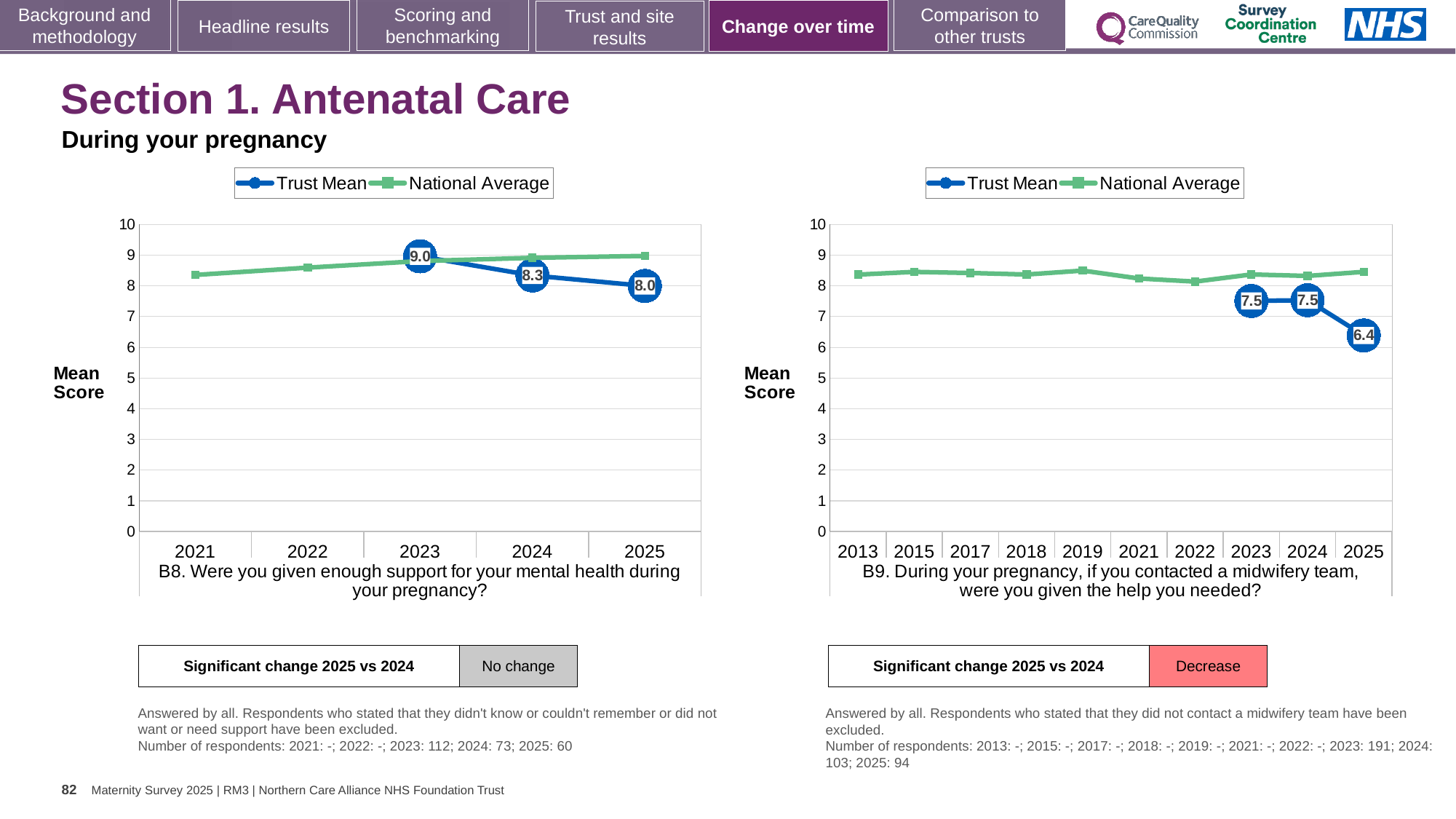
In the B9 chart (right), which year has the lowest Trust Mean? 2025 In the B8 chart (left), what is the difference between the Trust Mean for 2023 and 2025? 1.0 In the B9 chart (right), what is the Trust Mean for 2025? 6.4 In the B9 chart (right), is the National Average for 2025 greater or less than 8? greater How many years are shown on the x axis of the B9 chart (right)? 10 In the B8 chart (left), does the Trust Mean rise or fall from 2023 to 2025? fall In the B8 chart (left), what is the Trust Mean for 2023? 9.0 How many series does the legend of the B8 chart (left) list? 2 In the B9 chart (right), by how much did the Trust Mean fall from 2024 to 2025? 1.1 In the B8 chart (left), what is the Trust Mean for 2025? 8.0 In the B9 chart (right), what is the Trust Mean for 2024? 7.5 In the B8 chart (left), which year has the highest Trust Mean? 2023